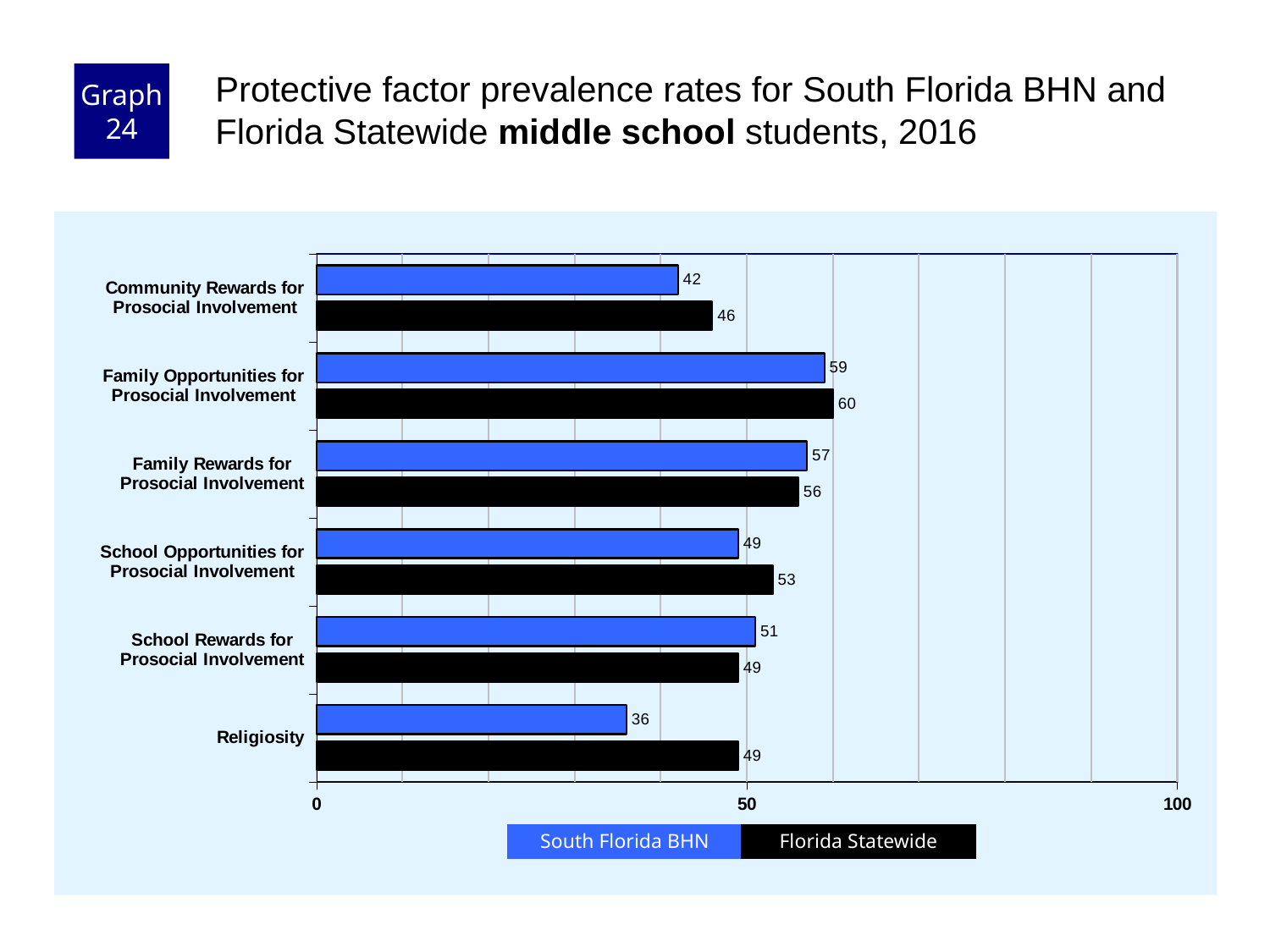
What is the difference between the Florida Statewide and South Florida BHN values for Religiosity? 13 Which category has the highest Florida Statewide value? Family Opportunities for Prosocial Involvement How many series does the legend list? 2 Which category has the lowest South Florida BHN value? Religiosity What is the Florida Statewide value for School Opportunities for Prosocial Involvement? 53 How many categories are shown on the chart? 6 Which is larger for Community Rewards for Prosocial Involvement: South Florida BHN or Florida Statewide? Florida Statewide What kind of chart is shown on the slide? bar chart Is the South Florida BHN value for Family Rewards for Prosocial Involvement greater or less than 50? greater Which series is shown in black? Florida Statewide What is the South Florida BHN value for Religiosity? 36 What is the South Florida BHN value for Family Opportunities for Prosocial Involvement? 59